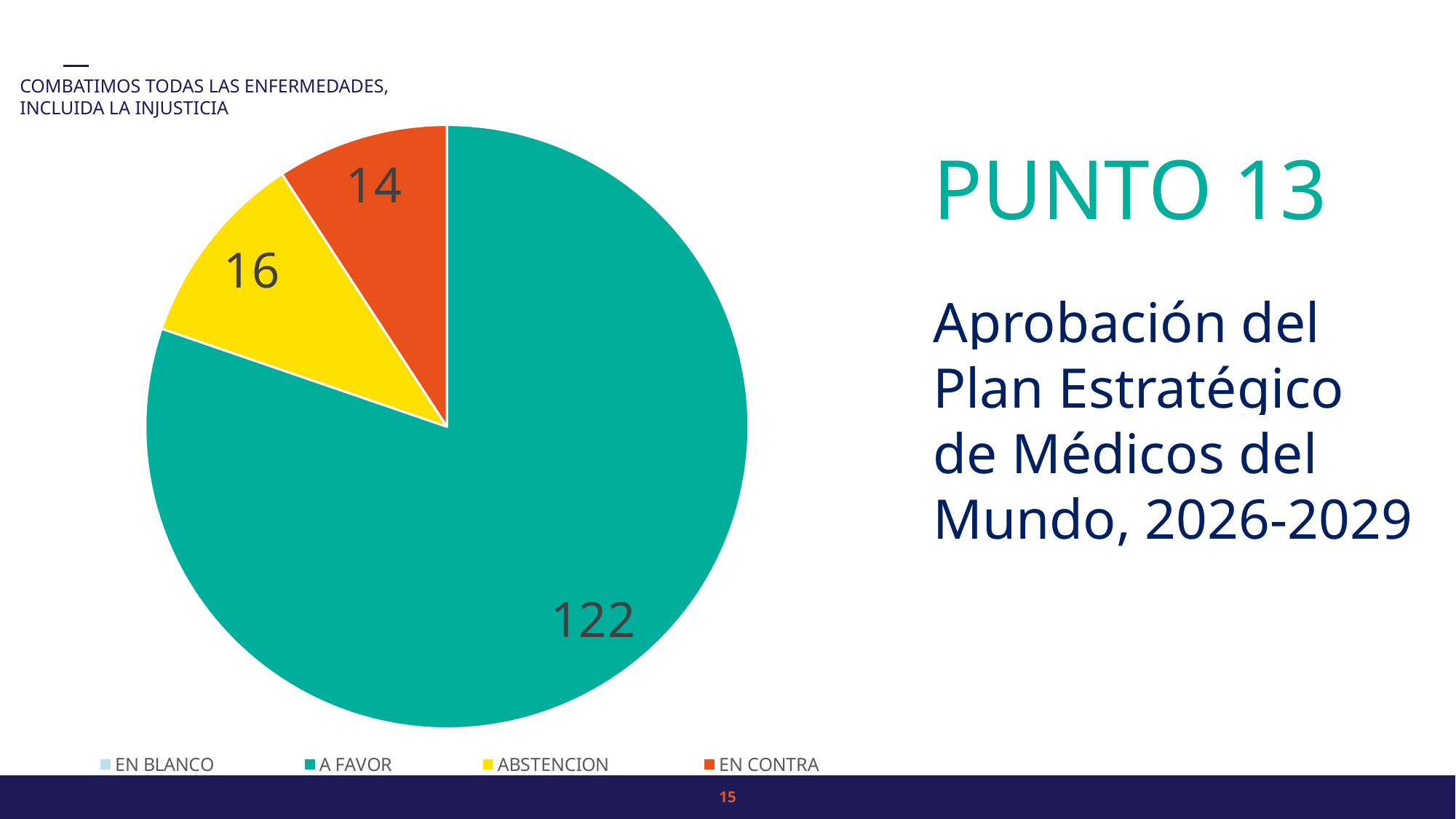
What is the difference between the A FAVOR value and the ABSTENCION value? 106 What is the value for A FAVOR in the pie chart? 122 Which legend category has no visible slice in the pie chart? EN BLANCO Which is larger, the value for ABSTENCION or the value for EN CONTRA? ABSTENCION Which category has the largest slice in the pie chart? A FAVOR What colour is the A FAVOR slice in the pie chart? Teal Of the slices visible in the pie chart, which category is the smallest? EN CONTRA What type of chart is shown on the slide? Pie chart What is the value for EN CONTRA in the pie chart? 14 How many categories does the legend of the pie chart list? 4 What is the difference between the ABSTENCION value and the EN CONTRA value? 2 What is the value for ABSTENCION in the pie chart? 16